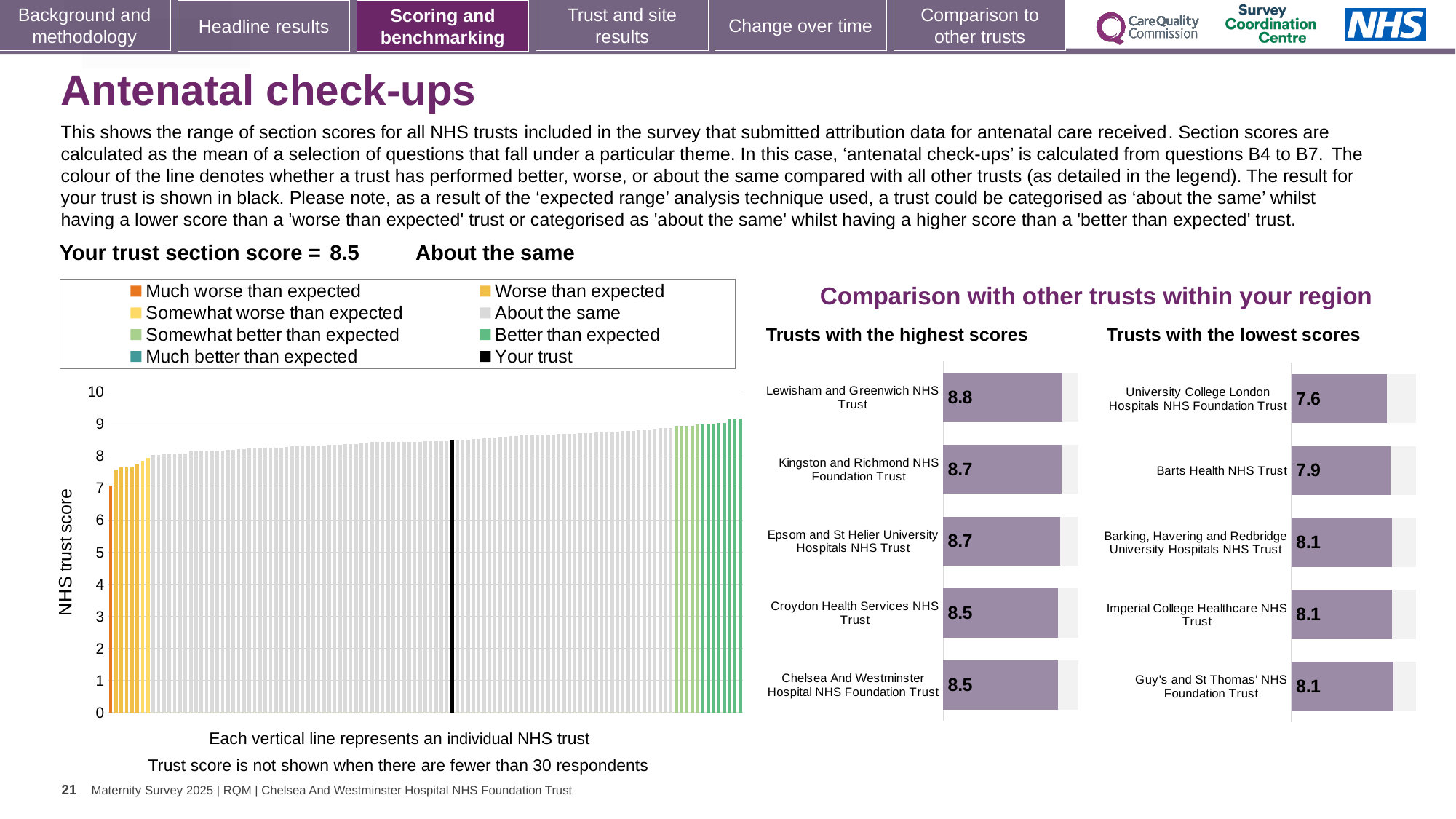
In the 'Trusts with the highest scores' chart, what is the score for Croydon Health Services NHS Trust? 8.5 How many entries does the legend of the main 'NHS trust score' chart list? 8 In the 'Trusts with the highest scores' chart, what is the score for Lewisham and Greenwich NHS Trust? 8.8 In the 'Trusts with the highest scores' chart, what is the difference between the scores of Lewisham and Greenwich NHS Trust and Croydon Health Services NHS Trust? 0.3 In the 'Trusts with the lowest scores' chart, which trust has the lowest score? University College London Hospitals NHS Foundation Trust In the 'Trusts with the lowest scores' chart, which has the larger score: Barts Health NHS Trust or University College London Hospitals NHS Foundation Trust? Barts Health NHS Trust How many trusts are shown in the 'Trusts with the lowest scores' chart? 5 In the 'Trusts with the highest scores' chart, which trust has the highest score? Lewisham and Greenwich NHS Trust In the main 'NHS trust score' chart, is the value for your trust (the black bar) greater or less than 8? greater In the 'Trusts with the lowest scores' chart, what is the score for Barts Health NHS Trust? 7.9 In the main 'NHS trust score' chart, do the trust scores rise or fall from left to right? Rise What kind of chart is the main 'NHS trust score' chart? Bar chart